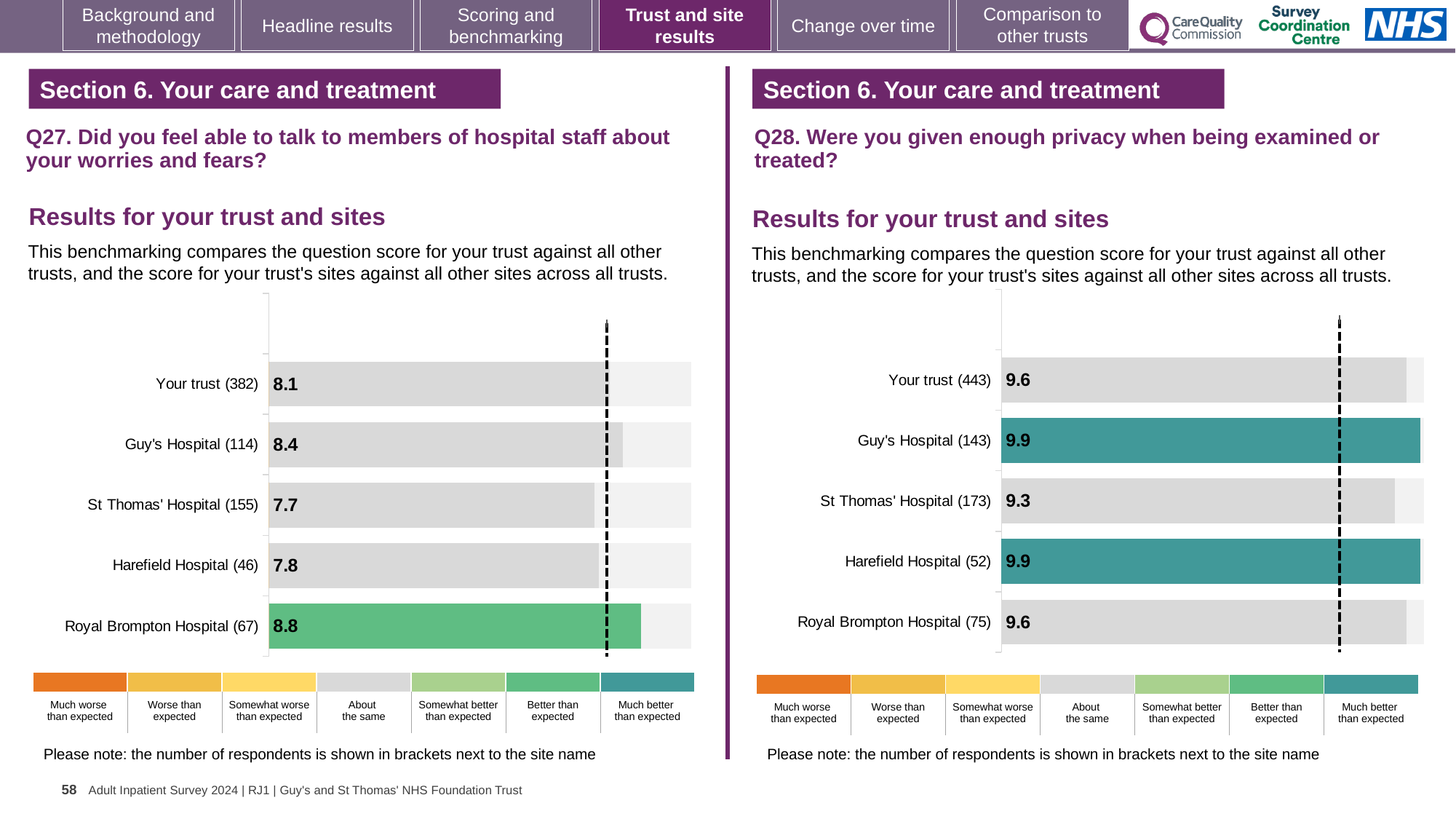
In the Q28 chart (right), what is the score for St Thomas' Hospital? 9.3 In the Q28 chart (right), which site has the lowest score? St Thomas' Hospital In the Q27 chart (left), how many bars are plotted? 5 In the Q27 chart (left), what is the difference between the scores for Royal Brompton Hospital and St Thomas' Hospital? 1.1 In the Q28 chart (right), which has the higher score, Harefield Hospital or Royal Brompton Hospital? Harefield Hospital In the Q27 chart (left), which has the higher score, Guy's Hospital or Harefield Hospital? Guy's Hospital In the Q27 chart (left), what is the score for Your trust? 8.1 In the Q28 chart (right), how many respondents are shown in brackets for Your trust? 443 In the Q28 chart (right), what is the difference between the scores for Guy's Hospital and Your trust? 0.3 In the Q27 chart (left), which site has the highest score? Royal Brompton Hospital What kind of chart is used on the left side of the slide for Q27? Bar chart In the Q27 chart (left), which site has the lowest score? St Thomas' Hospital